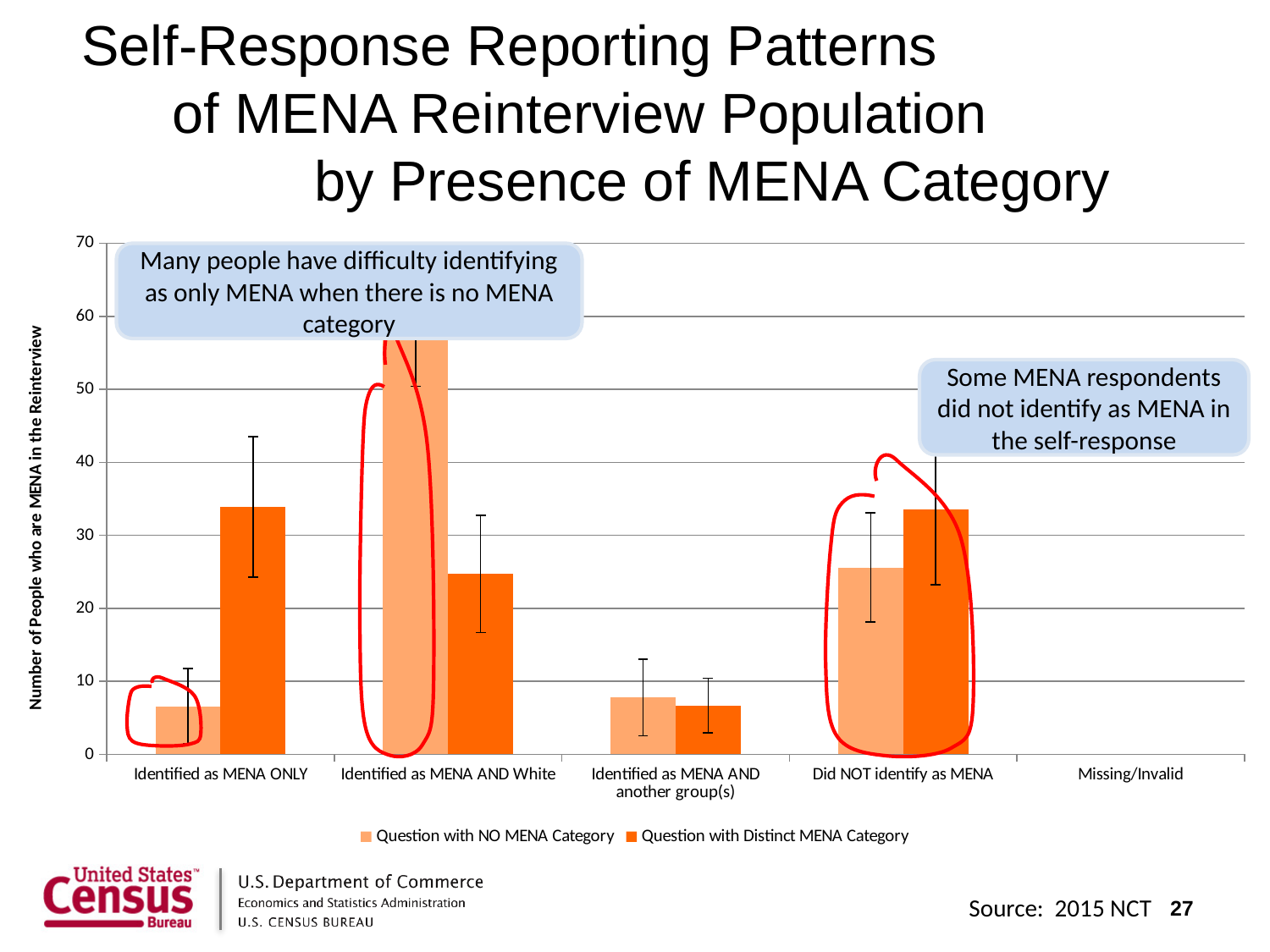
How many series does the chart's legend list? 2 How many categories are shown along the x axis of the chart? 5 Is the value for 'Question with Distinct MENA Category' at 'Identified as MENA ONLY' greater or less than 30? greater For 'Identified as MENA AND White', which series has the larger value? Question with NO MENA Category Is the value for 'Question with NO MENA Category' at 'Identified as MENA ONLY' greater or less than 10? less Is the value for 'Question with Distinct MENA Category' at 'Identified as MENA AND White' greater or less than 30? less What is the title of the chart's vertical axis? Number of People who are MENA in the Reinterview For 'Identified as MENA ONLY', which series has the larger value? Question with Distinct MENA Category Which category has the highest value for the 'Question with NO MENA Category' series? Identified as MENA AND White For 'Did NOT identify as MENA', which series has the larger value? Question with Distinct MENA Category What kind of chart is shown on the slide? bar chart